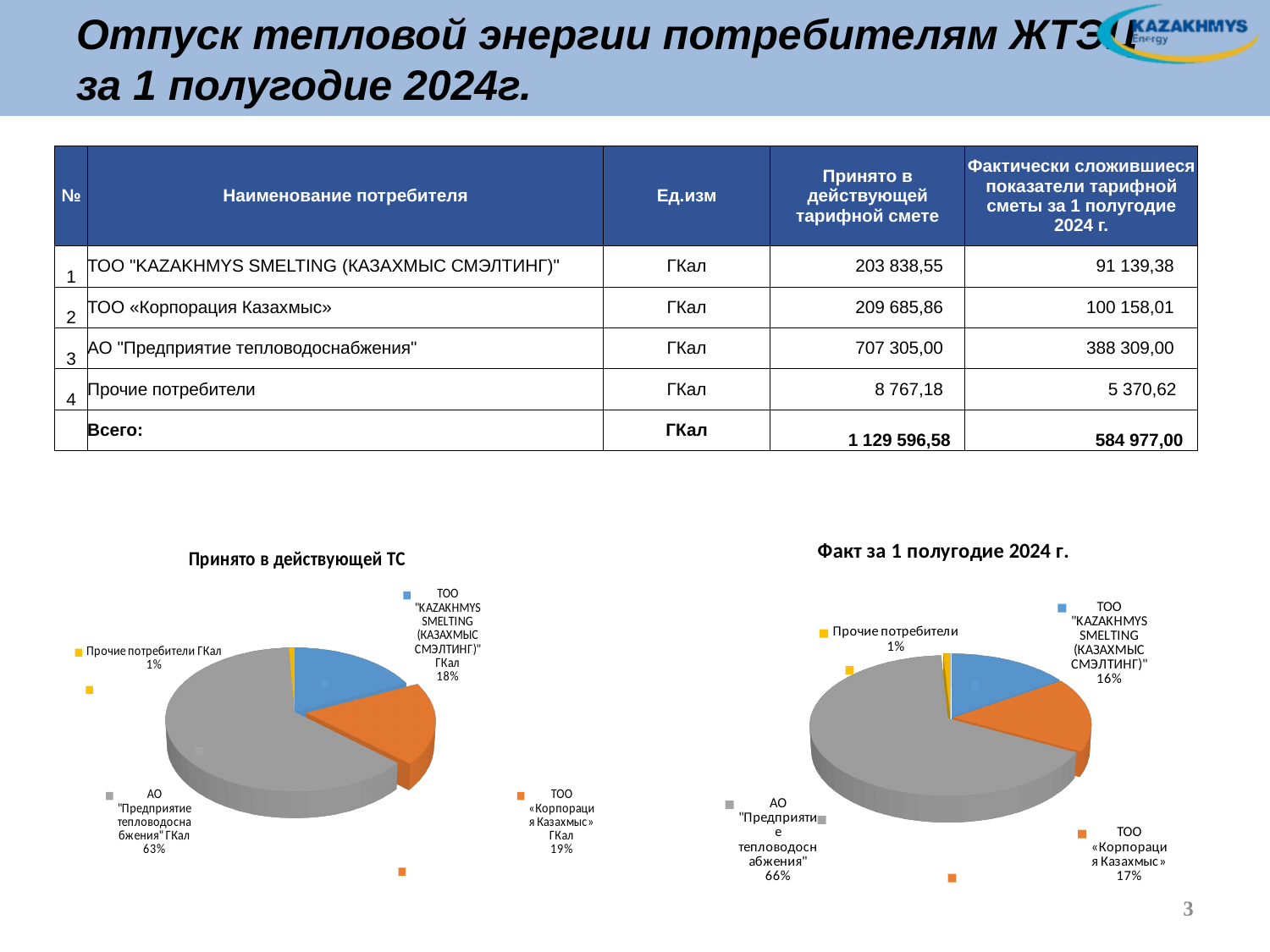
In the chart titled "Принято в действующей ТС", what share does АО "Предприятие тепловодоснабжения" have? 63% In the chart titled "Факт за 1 полугодие 2024 г.", what share does Прочие потребители have? 1% In the chart titled "Принято в действующей ТС", which category has the smallest slice? Прочие потребители ГКал In the chart titled "Факт за 1 полугодие 2024 г.", what is the difference in percentage points between ТОО «Корпорация Казахмыс» and ТОО "KAZAKHMYS SMELTING (КАЗАХМЫС СМЭЛТИНГ)"? 1% In the chart titled "Принято в действующей ТС", what share does ТОО «Корпорация Казахмыс» have? 19% What kind of chart is the chart titled "Принято в действующей ТС"? Pie chart In the chart titled "Принято в действующей ТС", how many slices does the pie have? 4 In the chart titled "Факт за 1 полугодие 2024 г.", which category has the largest slice? АО "Предприятие тепловодоснабжения" What is the title of the pie chart on the right side of the slide? Факт за 1 полугодие 2024 г.